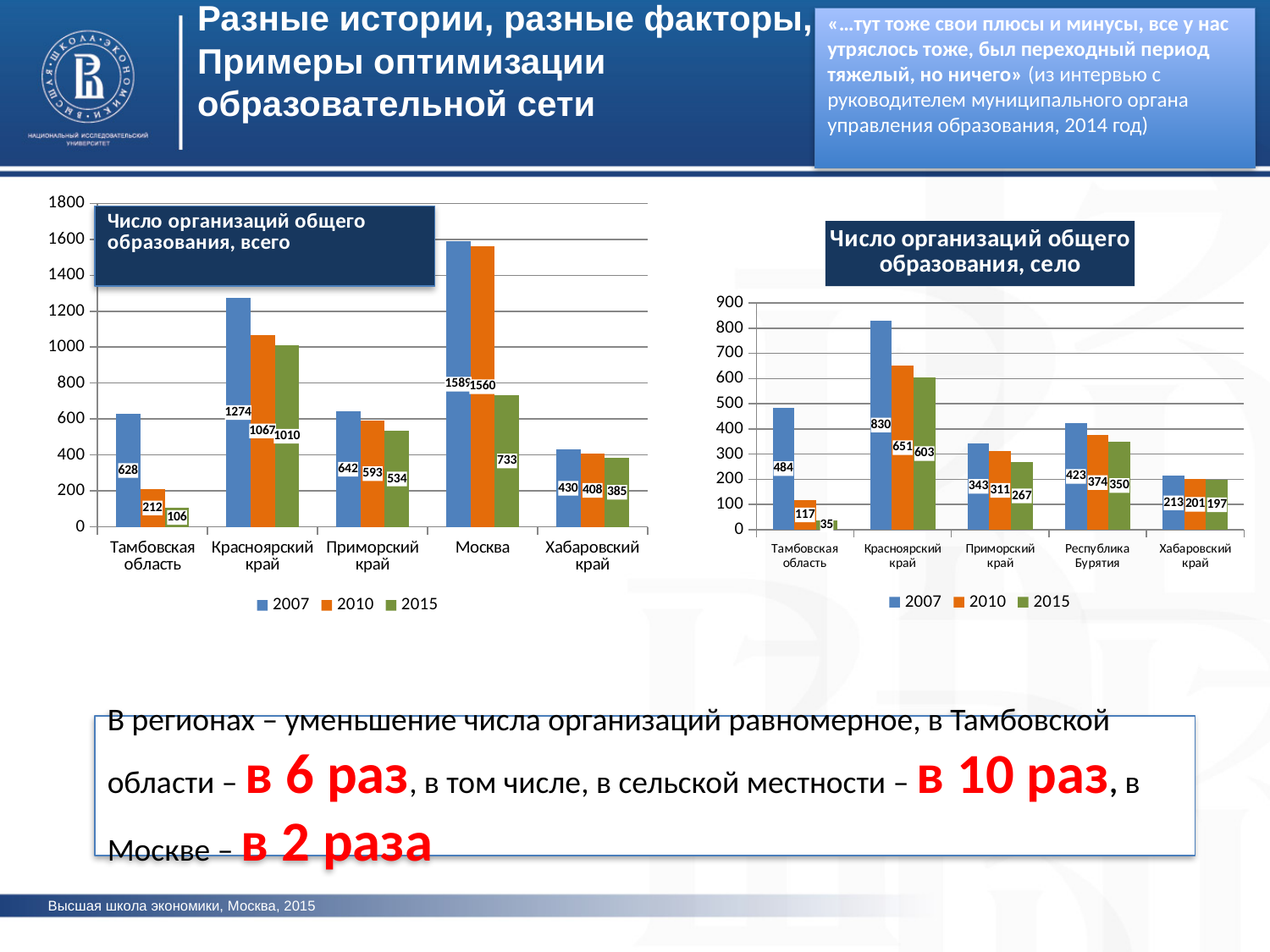
In the chart 'Число организаций общего образования, всего', what is the value for Тамбовская область in 2015? 106 In the chart 'Число организаций общего образования, село', how many series does the legend list? 3 In the chart 'Число организаций общего образования, село', what is the value for Тамбовская область in 2015? 35 In the chart 'Число организаций общего образования, всего', is the 2007 value for Красноярский край greater or less than 1200? greater In the chart 'Число организаций общего образования, всего', how many categories are shown on the x axis? 5 In the chart 'Число организаций общего образования, село', what is the value for Республика Бурятия in 2010? 374 In the chart 'Число организаций общего образования, всего', which category has the highest value for 2015? Красноярский край In the chart 'Число организаций общего образования, село', which category has the lowest value for 2007? Хабаровский край In the chart 'Число организаций общего образования, всего', what is the difference between the 2007 and 2015 values for Москва? 856 In the chart 'Число организаций общего образования, всего', what is the value for Москва in 2007? 1589 What type of chart is 'Число организаций общего образования, село'? bar chart In the chart 'Число организаций общего образования, село', which is larger: the 2007 value for Приморский край or the 2007 value for Республика Бурятия? Республика Бурятия